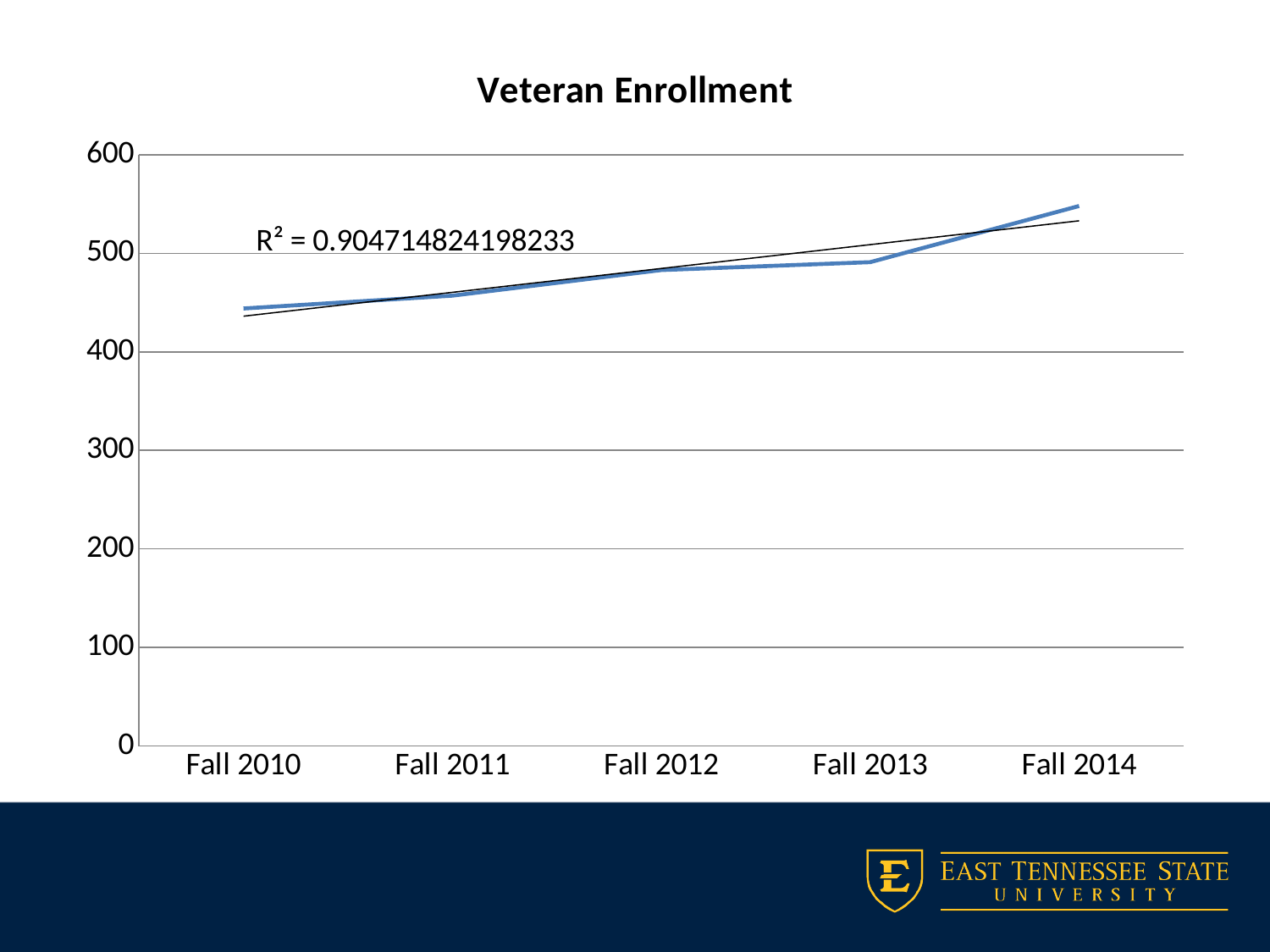
What R² value is printed on the chart for the trendline? 0.904714824198233 Which term has the highest veteran enrollment? Fall 2014 How many time points are plotted along the x axis? 5 Which term has the lowest veteran enrollment? Fall 2010 Is the value for Fall 2014 greater or less than 500? greater Is the value for Fall 2010 greater or less than 500? less What kind of chart is shown on the slide? Line chart What is the title of the chart? Veteran Enrollment Is the value for Fall 2012 greater or less than 400? greater Do the veteran enrollment values generally rise or fall from Fall 2010 to Fall 2014? Rise Which is larger, the value for Fall 2014 or the value for Fall 2011? Fall 2014 What is the highest value shown on the y axis? 600